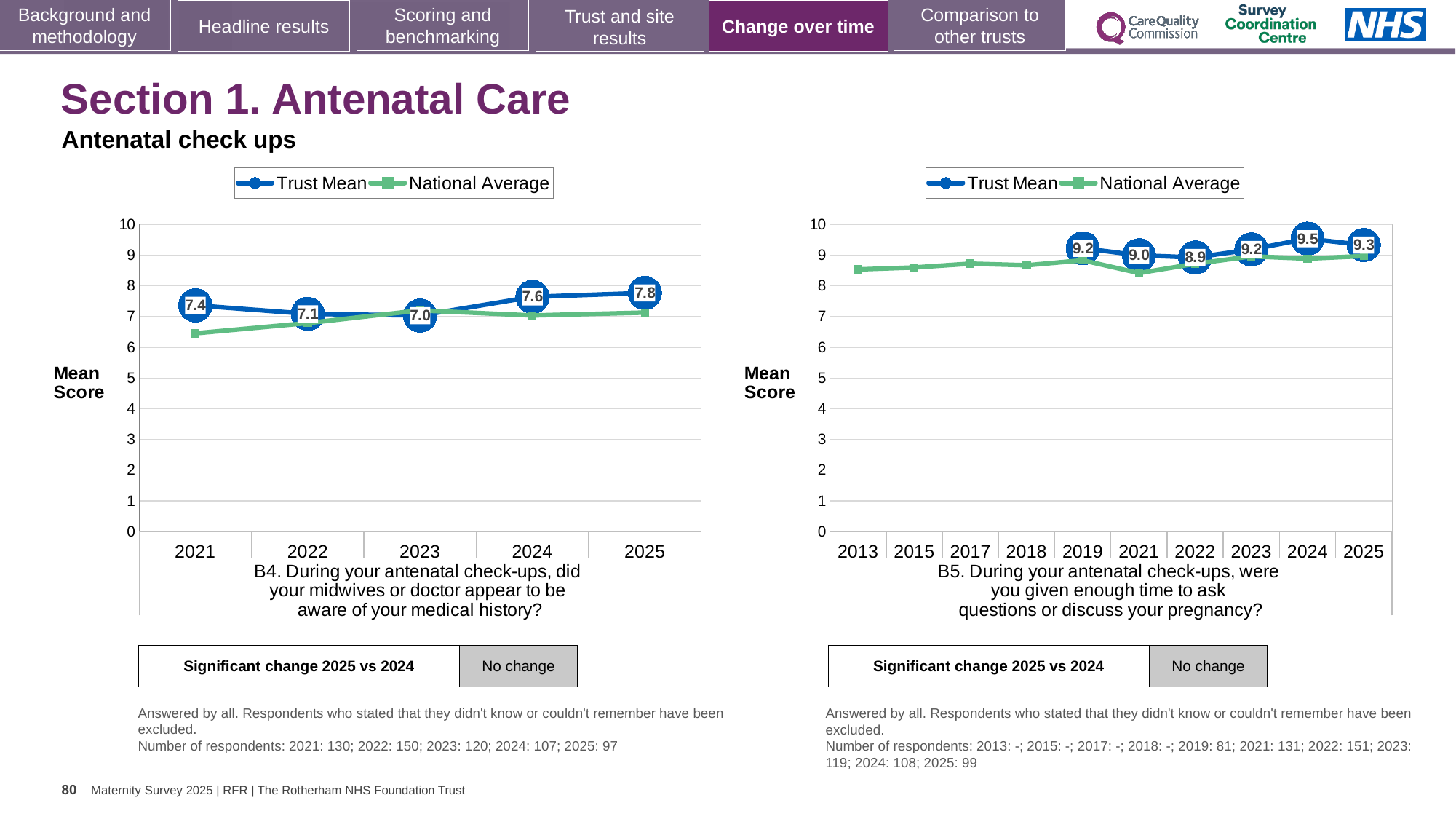
In the B4 chart (left), which year has the lowest Trust Mean score? 2023 In the B5 chart (right), what is the Trust Mean score for 2024? 9.5 In the B4 chart (left), is the National Average for 2021 greater or less than 7? less In the B4 chart (left), what is the difference between the Trust Mean scores for 2025 and 2021? 0.4 In the B4 chart (left), which year has the highest Trust Mean score? 2025 In the B5 chart (right), which year has the lowest Trust Mean score? 2022 How many series does the legend of the B4 chart (left) list? 2 What kind of chart is the B5 chart (right)? Line chart In the B4 chart (left), what is the Trust Mean score for 2025? 7.8 In the B4 chart (left), what is the Trust Mean score for 2023? 7.0 In the B5 chart (right), which is larger, the Trust Mean for 2019 or for 2021? 2019 In the B5 chart (right), how many years are shown on the x axis? 10